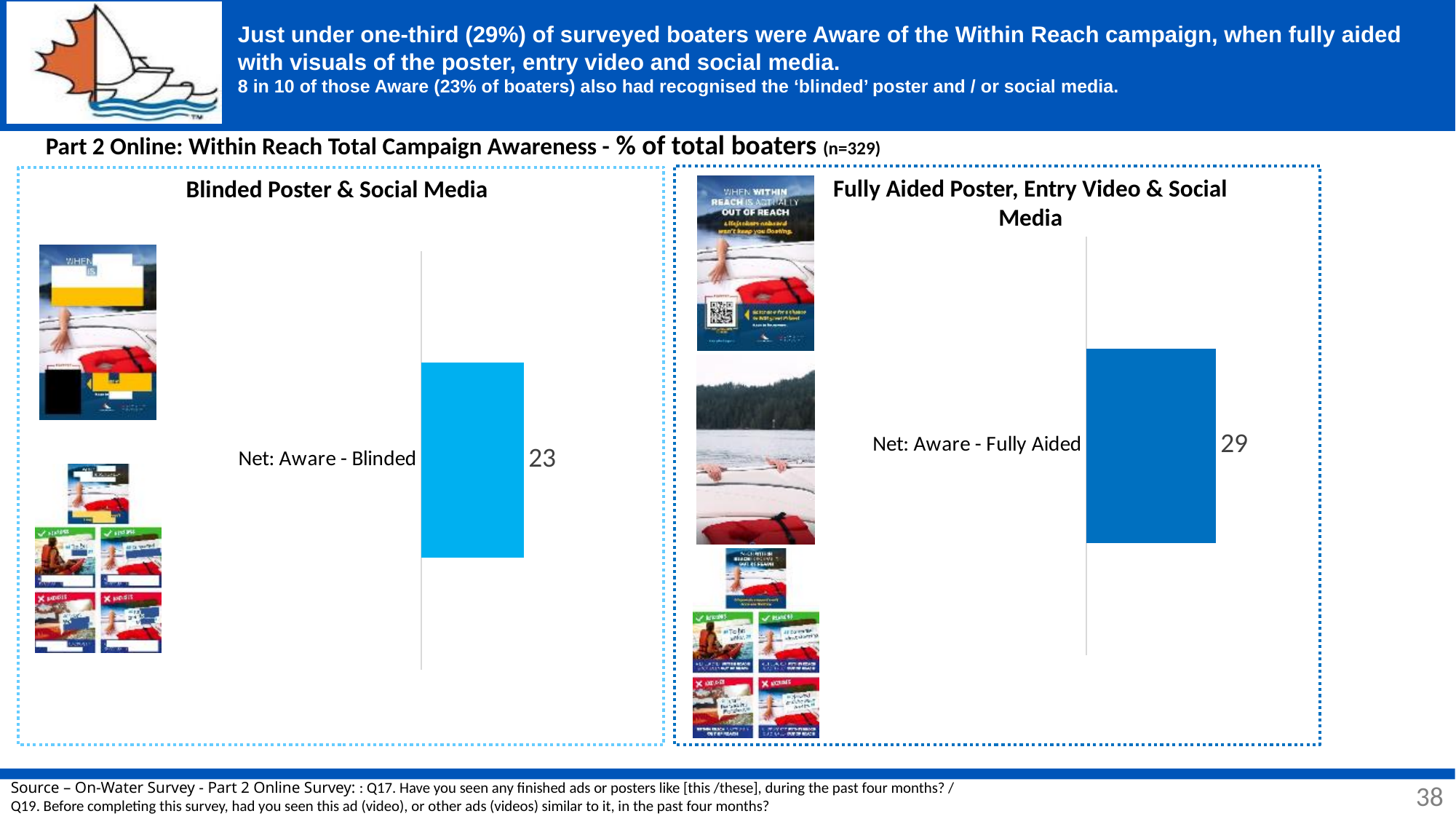
Comparing the two charts, which is larger: Net: Aware - Blinded or Net: Aware - Fully Aided? Net: Aware - Fully Aided What is the difference between the Net: Aware - Fully Aided value in the right chart and the Net: Aware - Blinded value in the left chart? 6 In the 'Fully Aided Poster, Entry Video & Social Media' chart, what is the value for Net: Aware - Fully Aided? 29 What kind of chart is the 'Fully Aided Poster, Entry Video & Social Media' chart? bar chart In the 'Blinded Poster & Social Media' chart, what is the value for Net: Aware - Blinded? 23 What is the title of the chart on the right side of the slide? Fully Aided Poster, Entry Video & Social Media What kind of chart is the 'Blinded Poster & Social Media' chart? bar chart How many bars are plotted in the 'Fully Aided Poster, Entry Video & Social Media' chart? 1 How many bars are plotted in the 'Blinded Poster & Social Media' chart? 1 What is the category label of the bar in the 'Blinded Poster & Social Media' chart? Net: Aware - Blinded